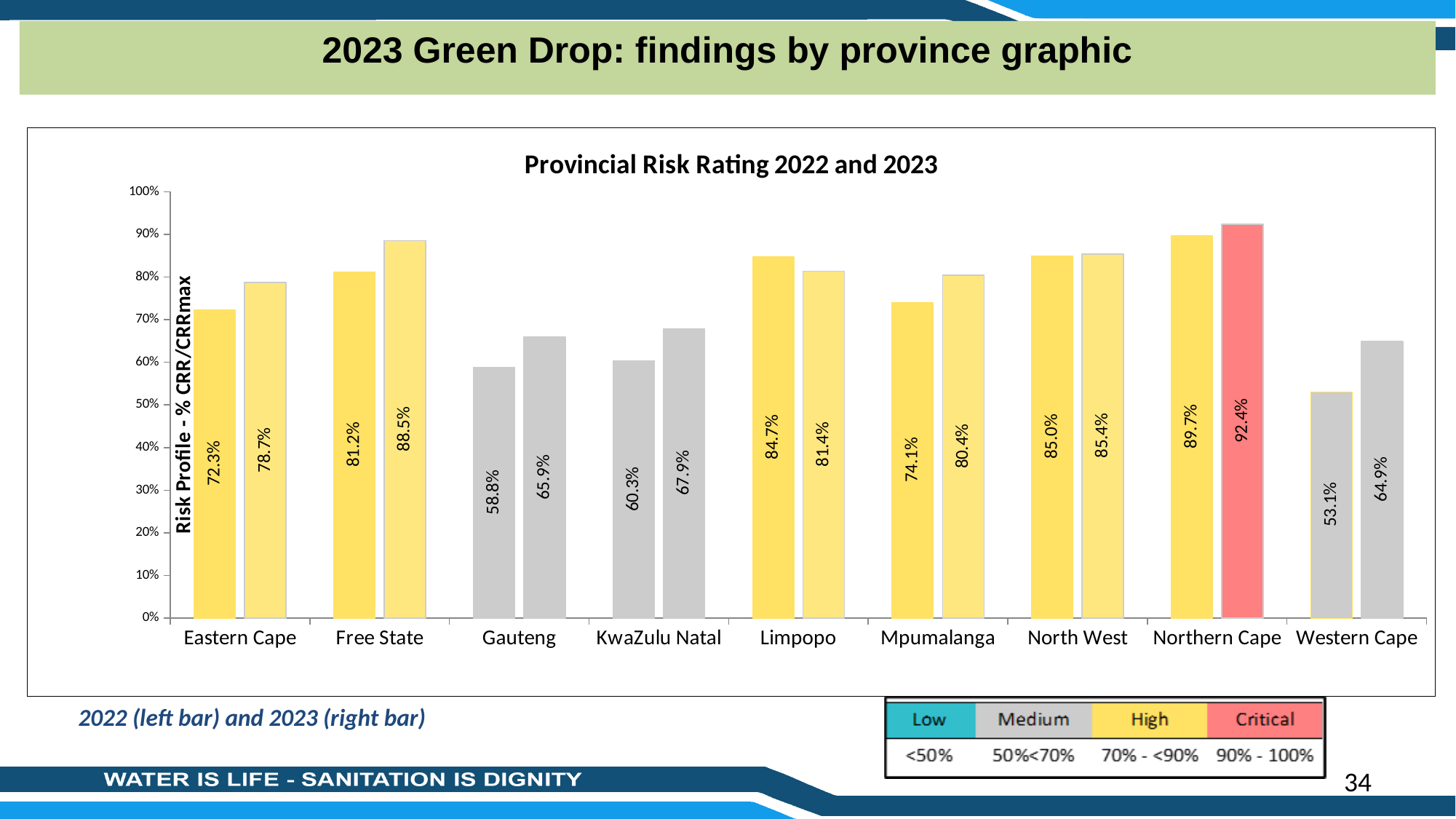
Which province has the highest 2023 (right bar) risk rating? Northern Cape What is the 2023 (right bar) risk rating for Northern Cape? 92.4% How many provinces are shown on the x axis of the chart? 9 What is the title of the chart? Provincial Risk Rating 2022 and 2023 What kind of chart is shown on the slide? Bar chart What is the 2023 (right bar) risk rating for Western Cape? 64.9% What is the 2022 (left bar) risk rating for Gauteng? 58.8% Which risk category does the red colour represent in the legend? Critical Which province has the lowest 2022 (left bar) risk rating? Western Cape Is the 2022 (left bar) value for KwaZulu Natal greater or less than 70%? less For Limpopo, which is larger: the 2022 (left bar) or the 2023 (right bar) risk rating? 2022 By how many percentage points did Free State's risk rating change from 2022 (81.2%) to 2023 (88.5%)? 7.3 percentage points